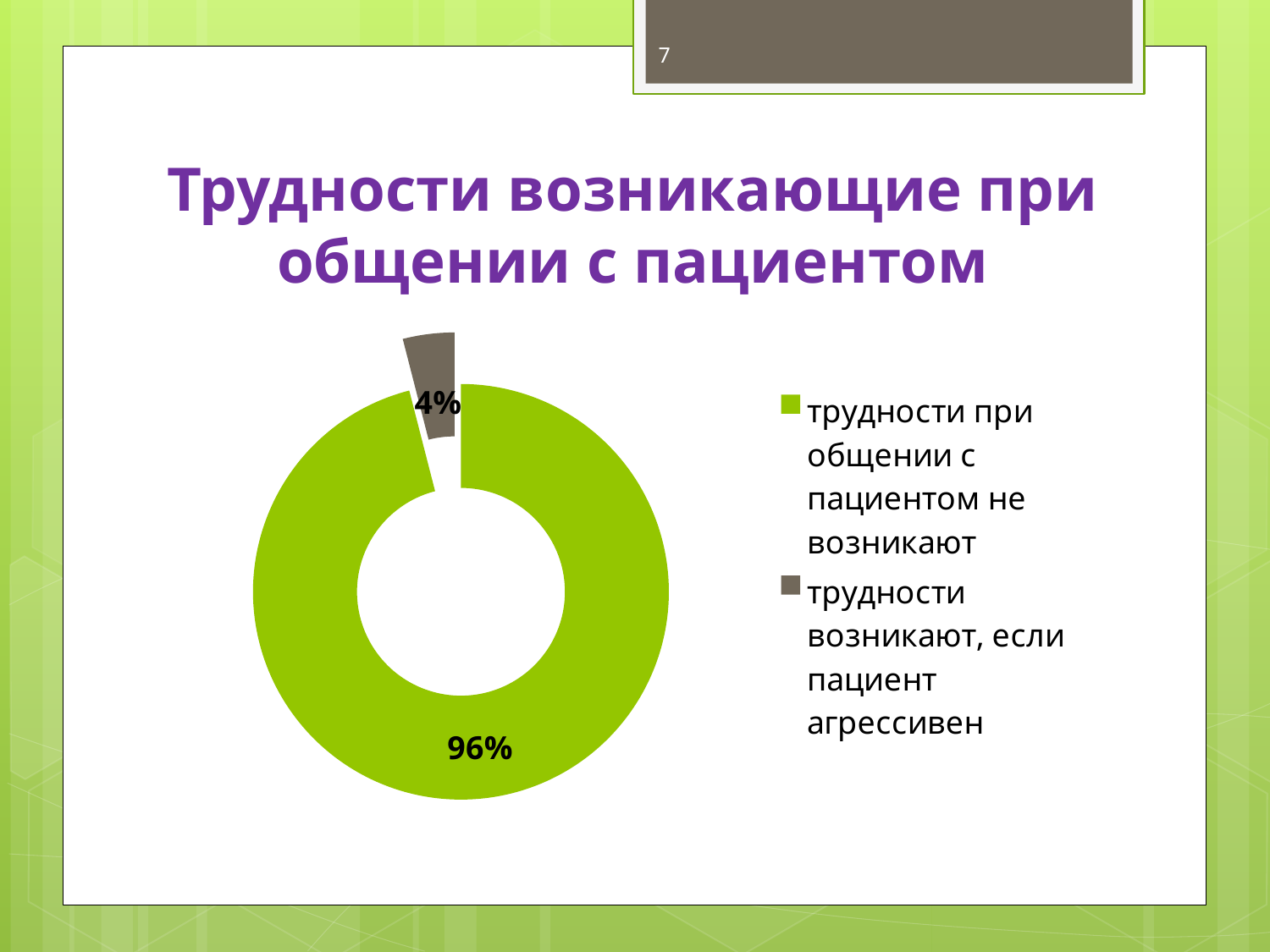
What share of the chart is labelled "трудности возникают, если пациент агрессивен"? 4% How many entries does the legend list? 2 What colour is the slice labelled 4%? grey Which category has the smallest share of the chart? трудности возникают, если пациент агрессивен What is the difference in percentage points between the two slices of the chart? 92 What is the total of the two percentages shown on the chart? 100% Which is larger: the share for "трудности при общении с пациентом не возникают" or the share for "трудности возникают, если пациент агрессивен"? трудности при общении с пациентом не возникают Which category has the largest share of the chart? трудности при общении с пациентом не возникают What kind of chart is shown on the slide? doughnut (pie) chart What share of the chart is labelled "трудности при общении с пациентом не возникают"? 96% How many categories does the chart show? 2 What colour is the slice labelled 96%? green